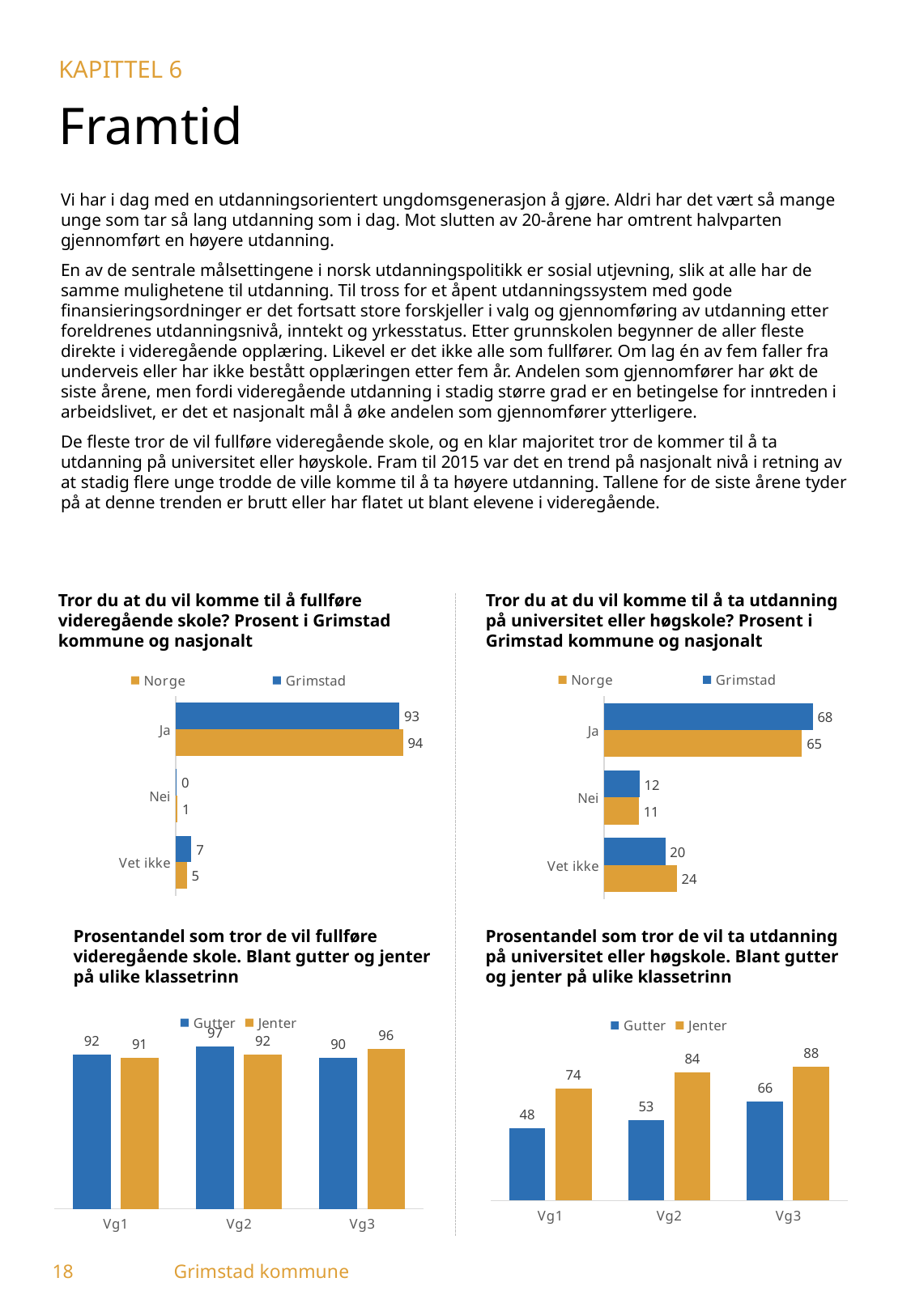
In the top-left chart (Tror du at du vil komme til å fullføre videregående skole?), what is the difference between the Norge and Grimstad values for 'Ja'? 1 In the bottom-right chart (Prosentandel som tror de vil ta utdanning på universitet eller høgskole), what is the difference between Jenter and Gutter at Vg2? 31 In the top-left chart (Tror du at du vil komme til å fullføre videregående skole?), what is the value for Grimstad for 'Ja'? 93 In the top-right chart (Tror du at du vil komme til å ta utdanning på universitet eller høgskole?), which is larger for 'Ja': Grimstad or Norge? Grimstad In the top-left chart (Tror du at du vil komme til å fullføre videregående skole?), what is the value for Norge for 'Vet ikke'? 5 In the bottom-right chart (Prosentandel som tror de vil ta utdanning på universitet eller høgskole), what is the value for Gutter at Vg1? 48 In the bottom-right chart (Prosentandel som tror de vil ta utdanning på universitet eller høgskole), do the Gutter values rise or fall from Vg1 to Vg3? Rise In the bottom-left chart (Prosentandel som tror de vil fullføre videregående skole), what is the value for Gutter at Vg2? 97 In the bottom-left chart (Prosentandel som tror de vil fullføre videregående skole), which class level has the highest value for Jenter? Vg3 In the top-right chart (Tror du at du vil komme til å ta utdanning på universitet eller høgskole?), what is the value for Norge for 'Vet ikke'? 24 What kind of chart is the top-right chart (Tror du at du vil komme til å ta utdanning på universitet eller høgskole?)? Bar chart In the top-right chart (Tror du at du vil komme til å ta utdanning på universitet eller høgskole?), how many series does the legend list? 2